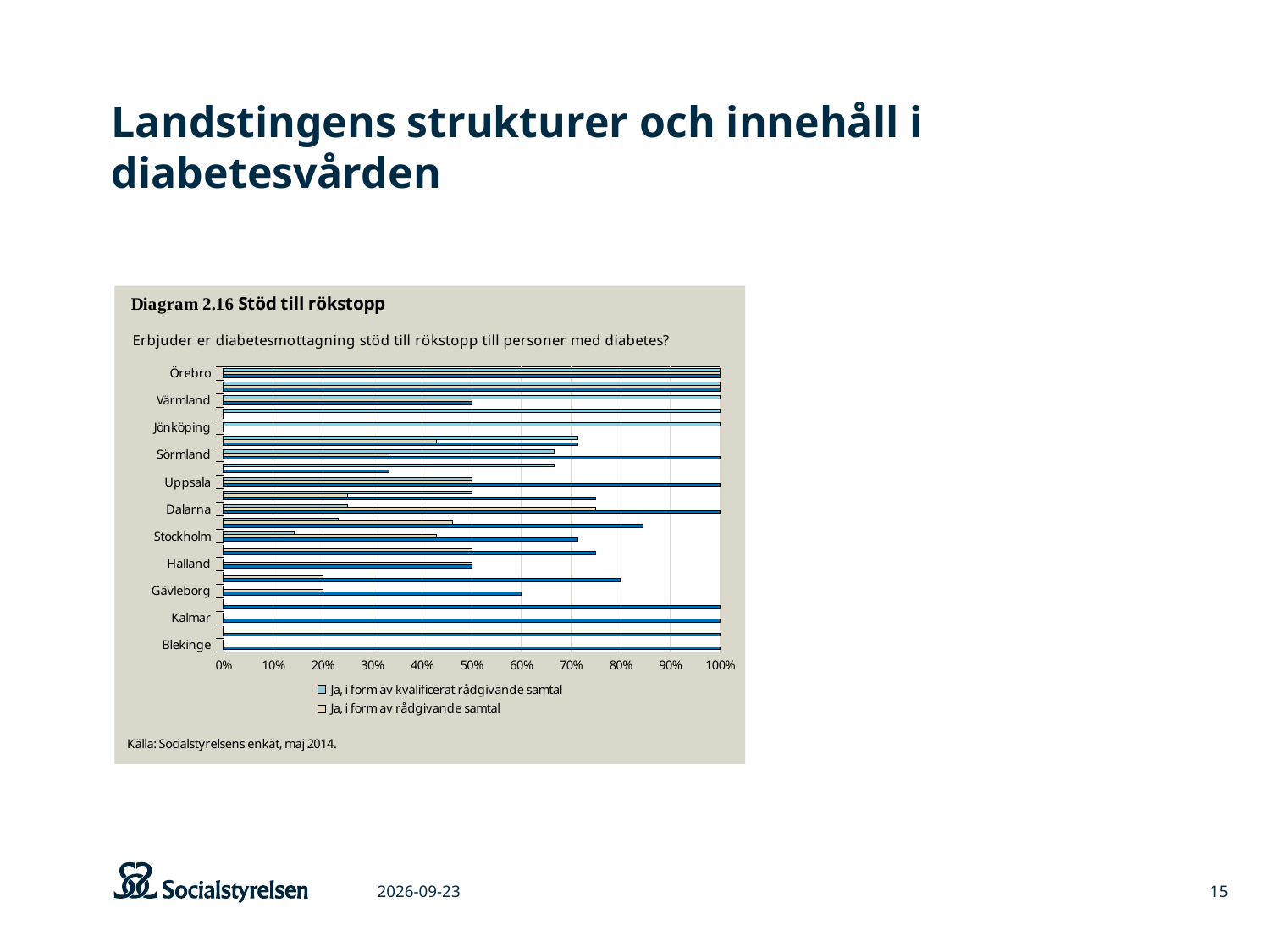
What is the value for Örebro in the series 'Ja, i form av kvalificerat rådgivande samtal'? 100% What kind of chart is shown on the slide? bar chart Is the value for Gävleborg in the series 'Ja, i form av kvalificerat rådgivande samtal' greater or less than 70%? less What is the title of the diagram? Diagram 2.16 Stöd till rökstopp What is the source given below the chart? Socialstyrelsens enkät, maj 2014. Is the value for Dalarna in the series 'Ja, i form av rådgivande samtal' greater or less than 40%? greater What is the value for Blekinge in the series 'Ja, i form av kvalificerat rådgivande samtal'? 0% Is the value for Stockholm in the series 'Ja, i form av kvalificerat rådgivande samtal' greater or less than 60%? less Which has the larger value in the series 'Ja, i form av rådgivande samtal', Halland or Dalarna? Dalarna How many series does the legend list? 2